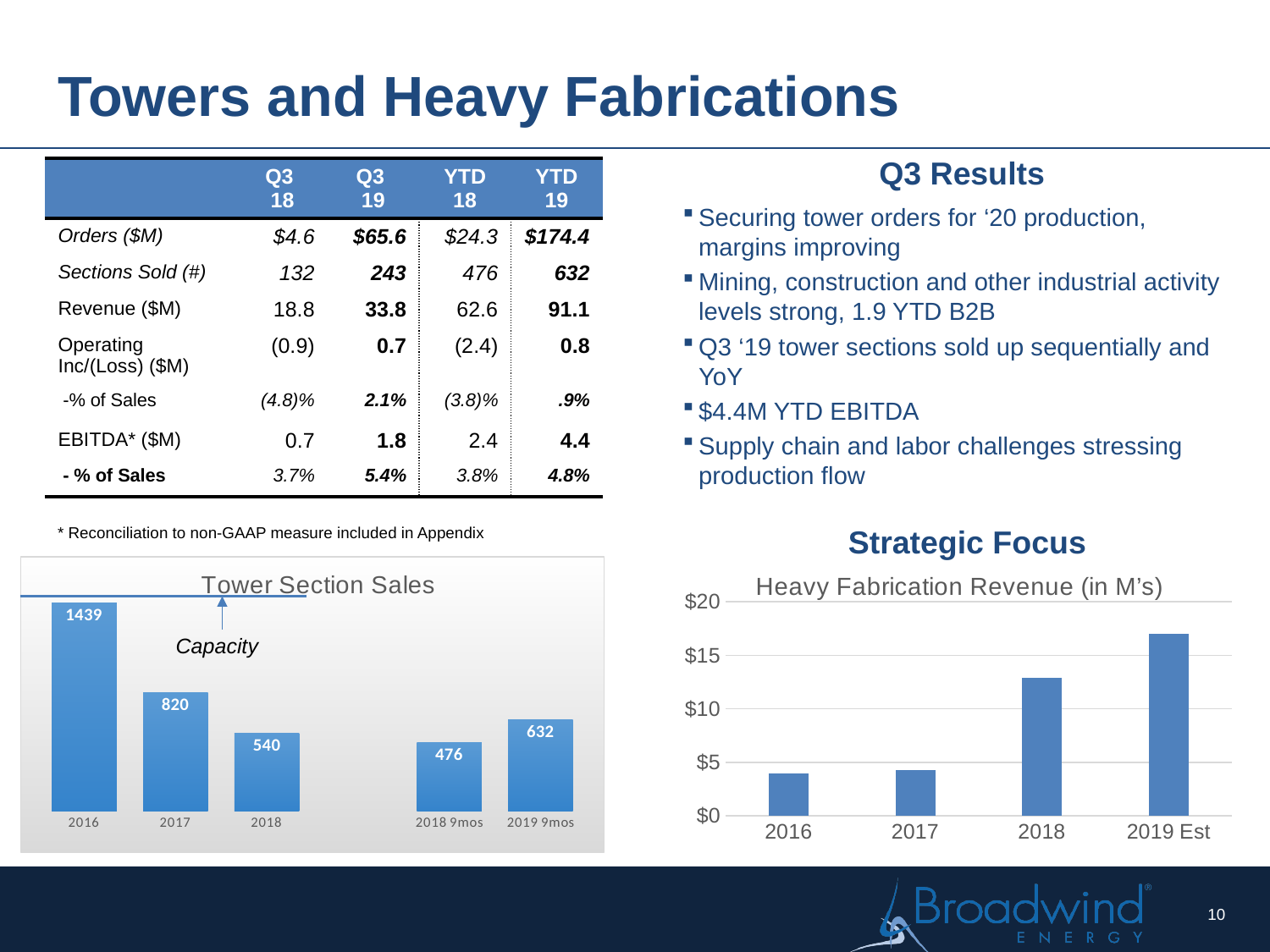
In the Tower Section Sales chart, which category has the highest value? 2016 In the Heavy Fabrication Revenue chart, which category has the highest value? 2019 Est How many bars are shown in the Tower Section Sales chart? 5 In the Heavy Fabrication Revenue chart, is the value for 2019 Est greater or less than $15? greater In the Tower Section Sales chart, which is larger, the value for 2017 or the value for 2018? 2017 In the Tower Section Sales chart, which category has the lowest value? 2018 9mos In the Tower Section Sales chart, do the values rise or fall from 2016 to 2018? fall In the Heavy Fabrication Revenue chart, is the value for 2016 greater or less than $5? less In the Tower Section Sales chart, what is the value for 2016? 1439 In the Tower Section Sales chart, what is the difference between the 2019 9mos and 2018 9mos values? 156 What kind of chart is the Heavy Fabrication Revenue chart? bar chart In the Tower Section Sales chart, what is the value for 2019 9mos? 632